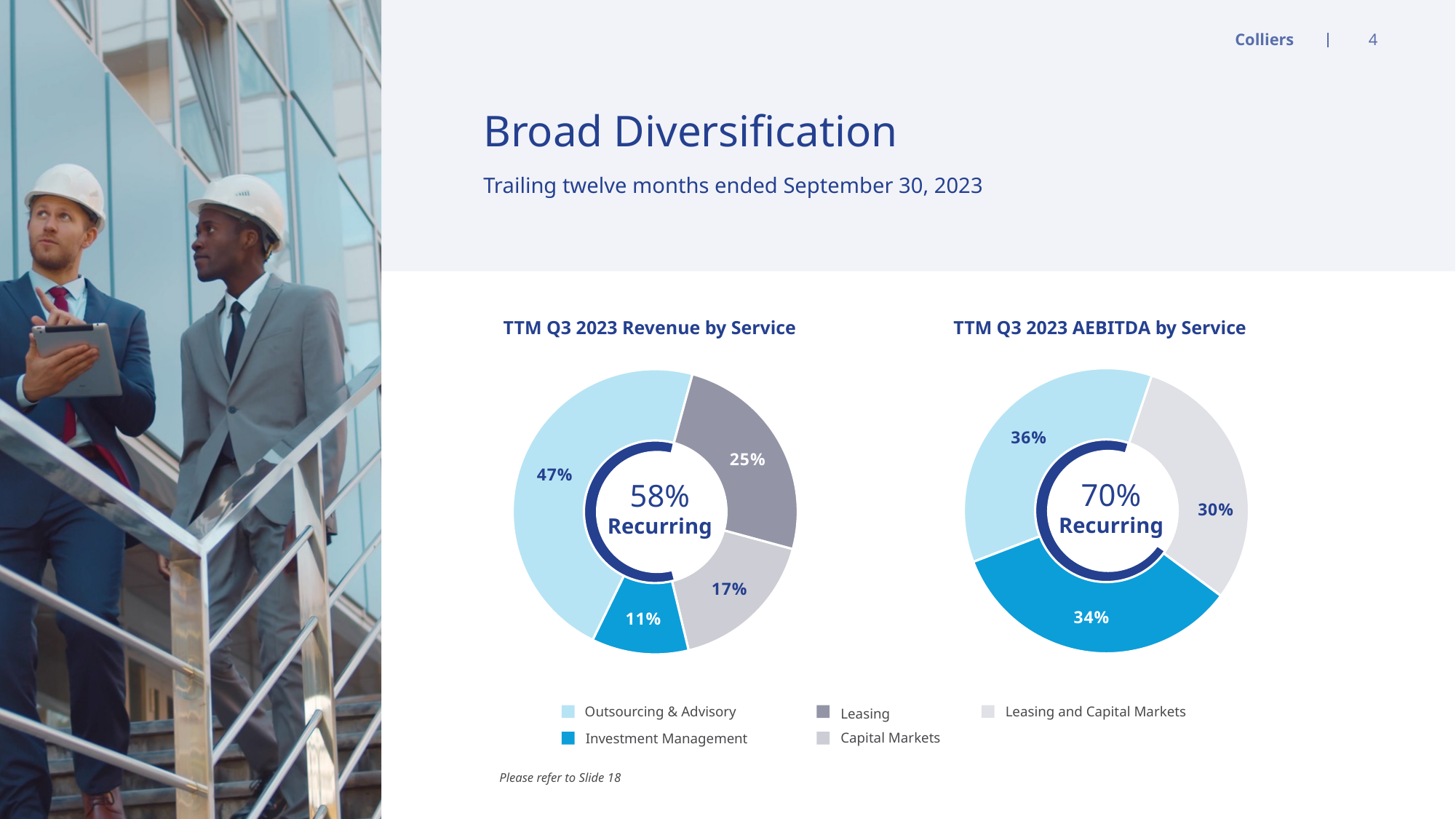
In the TTM Q3 2023 AEBITDA by Service chart, what share comes from Leasing and Capital Markets? 30% In the TTM Q3 2023 AEBITDA by Service chart, which service has the largest share? Outsourcing & Advisory In the TTM Q3 2023 Revenue by Service chart, what share of revenue comes from Outsourcing & Advisory? 47% In the TTM Q3 2023 Revenue by Service chart, which service has the smallest share? Investment Management In the TTM Q3 2023 AEBITDA by Service chart, what share comes from Investment Management? 34% In the TTM Q3 2023 Revenue by Service chart, what share of revenue comes from Leasing? 25% How many segments does the TTM Q3 2023 Revenue by Service chart have? 4 What type of chart is the TTM Q3 2023 AEBITDA by Service chart? Pie (donut) chart What recurring percentage is shown in the centre of the TTM Q3 2023 AEBITDA by Service chart? 70% In the TTM Q3 2023 Revenue by Service chart, what share of revenue comes from Investment Management? 11% In the TTM Q3 2023 Revenue by Service chart, what is the difference between the Leasing share and the Capital Markets share? 8% In the TTM Q3 2023 AEBITDA by Service chart, which is larger: the Investment Management share or the Leasing and Capital Markets share? Investment Management